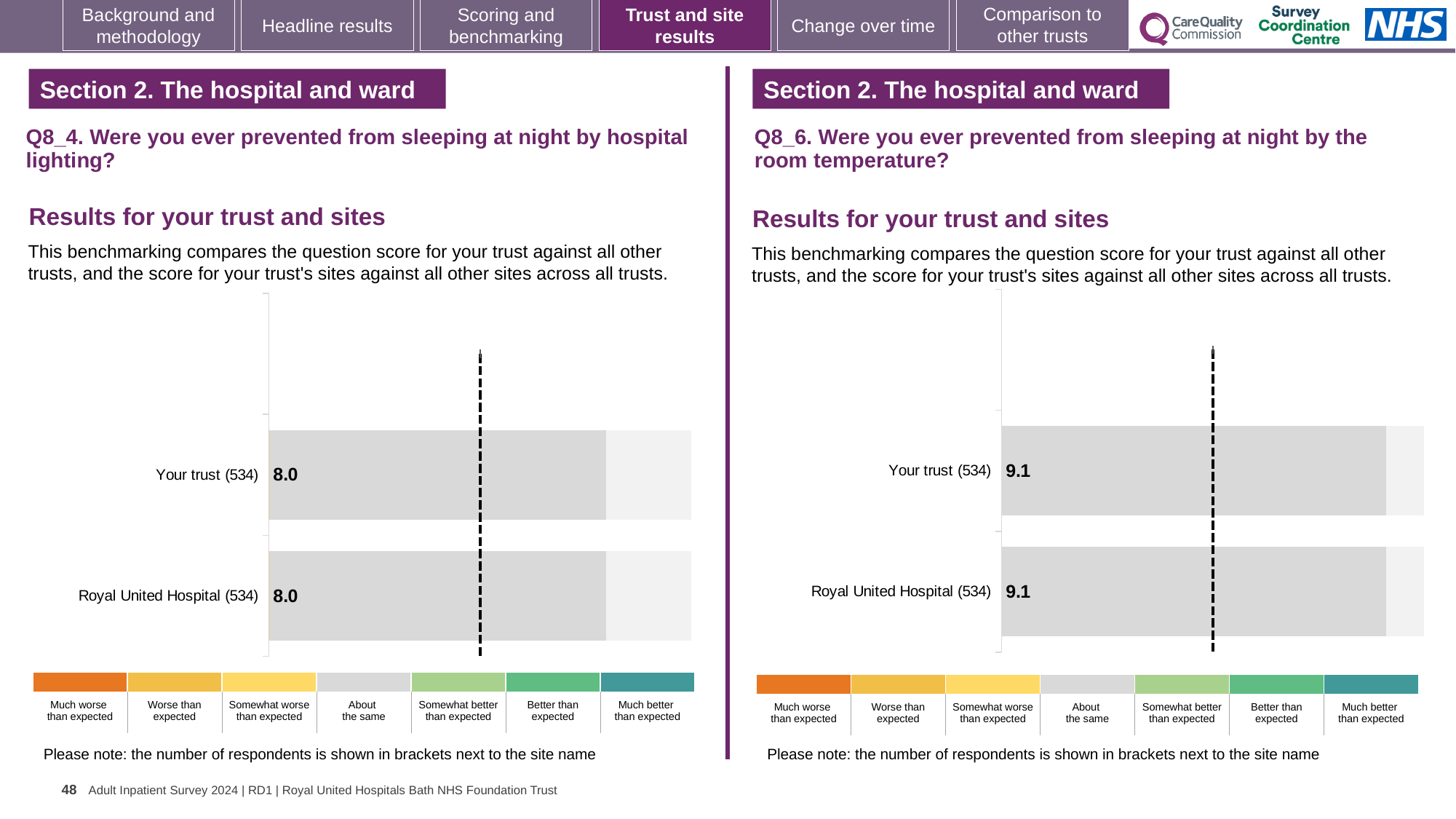
On the Q8_6 room temperature chart, what is the score for Your trust (534)? 9.1 How many bars are plotted on the Q8_6 room temperature chart? 2 On the Q8_4 hospital lighting chart, what is the score for Your trust (534)? 8.0 On the Q8_4 hospital lighting chart, what is the score for Royal United Hospital (534)? 8.0 What type of chart is used on the Q8_6 room temperature chart? Bar chart How many bars are plotted on the Q8_4 hospital lighting chart? 2 How many colour categories does the legend below the Q8_6 room temperature chart show? 7 On the Q8_6 room temperature chart, what is the score for Royal United Hospital (534)? 9.1 On the Q8_6 room temperature chart, what is the difference between the score for Your trust and the score for Royal United Hospital? 0.0 On the Q8_4 hospital lighting chart, what is the difference between the score for Your trust and the score for Royal United Hospital? 0.0 On the Q8_4 hospital lighting chart, how many respondents are shown in brackets next to Royal United Hospital? 534